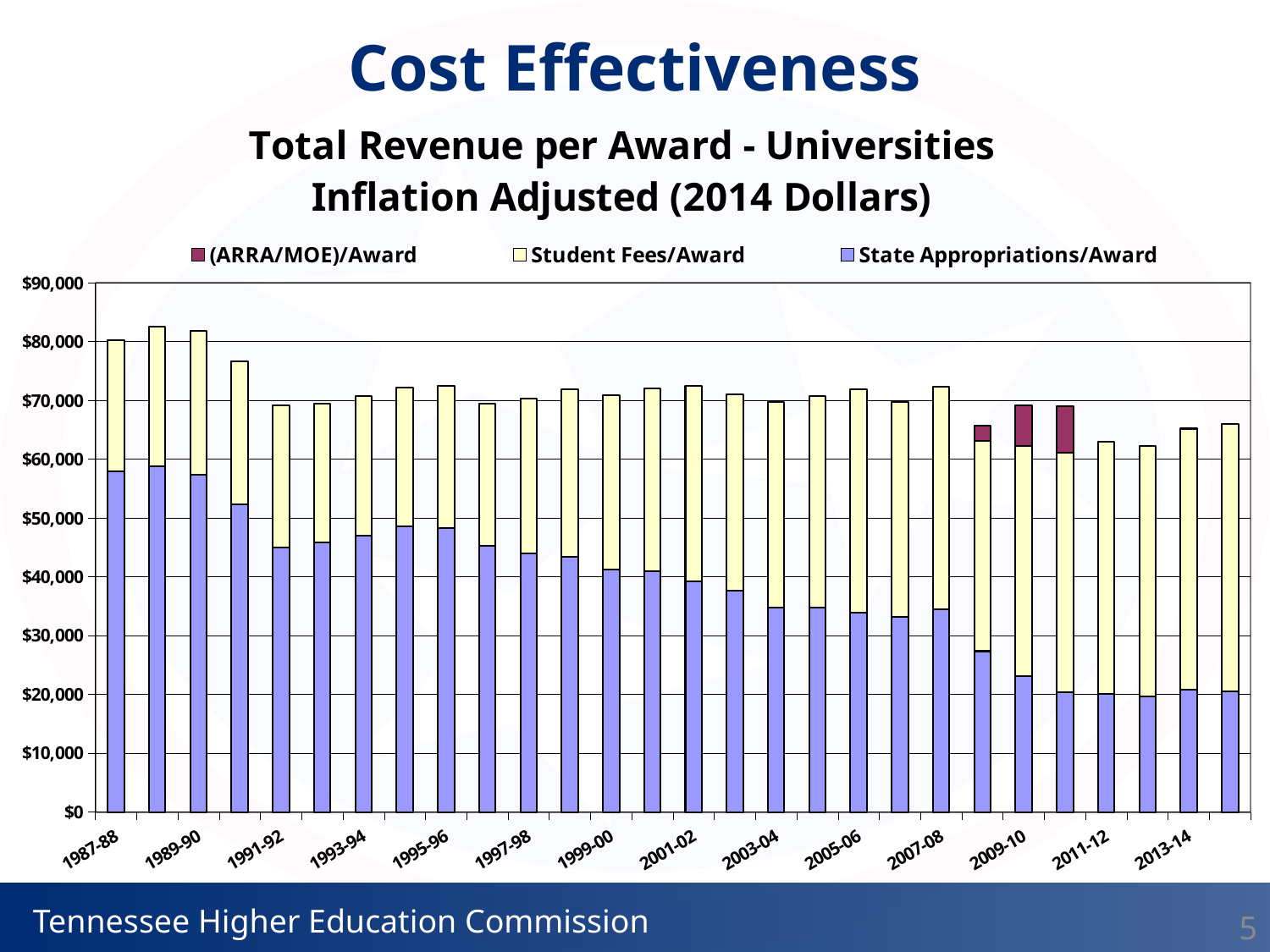
What kind of chart is shown on the slide? Stacked bar chart In how many years does the (ARRA/MOE)/Award series appear in the chart? 3 Which year has the larger State Appropriations/Award value, 1987-88 or 2013-14? 1987-88 Which year has the larger total revenue per award, 1989-90 or 2013-14? 1989-90 Which series is shown in yellow in the chart? Student Fees/Award Is the State Appropriations/Award value for 2009-10 greater or less than $30,000? less Is the State Appropriations/Award value for 1987-88 greater or less than $50,000? greater Does the State Appropriations/Award series generally rise or fall from 1987-88 to 2013-14? fall How many series does the legend list? 3 Is the total revenue per award for 1989-90 greater or less than $80,000? greater How many bars (academic years) are plotted in the chart? 28